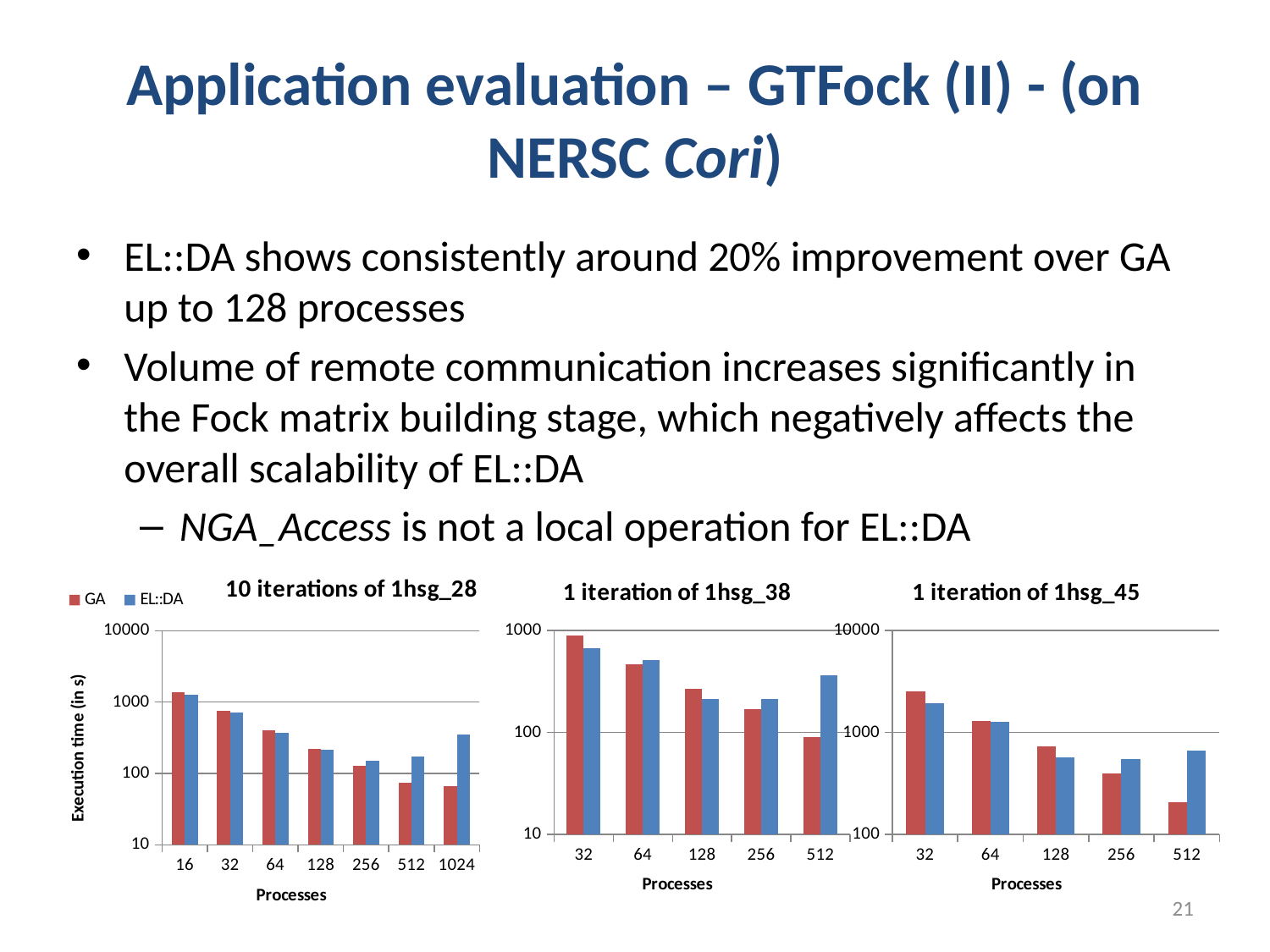
How many process counts are shown on the x axis of the '10 iterations of 1hsg_28' chart? 7 In the '10 iterations of 1hsg_28' chart, is the GA value at 512 processes greater or less than 100? less In the '1 iteration of 1hsg_38' chart, is the EL::DA value at 512 processes greater or less than 100? greater In the '1 iteration of 1hsg_45' chart, is the EL::DA value at 512 processes greater or less than 1000? less In the '1 iteration of 1hsg_38' chart, which series has the larger value at 32 processes, GA or EL::DA? GA In the '1 iteration of 1hsg_38' chart, at which process count is the GA execution time lowest? 512 How many process counts are shown on the x axis of the '1 iteration of 1hsg_38' chart? 5 In the '10 iterations of 1hsg_28' chart, which series has the larger value at 1024 processes, GA or EL::DA? EL::DA What kind of chart is the '10 iterations of 1hsg_28' chart? bar chart How many series does the legend on the '10 iterations of 1hsg_28' chart list? 2 In the '1 iteration of 1hsg_45' chart, does the GA execution time rise or fall as the number of processes increases? fall